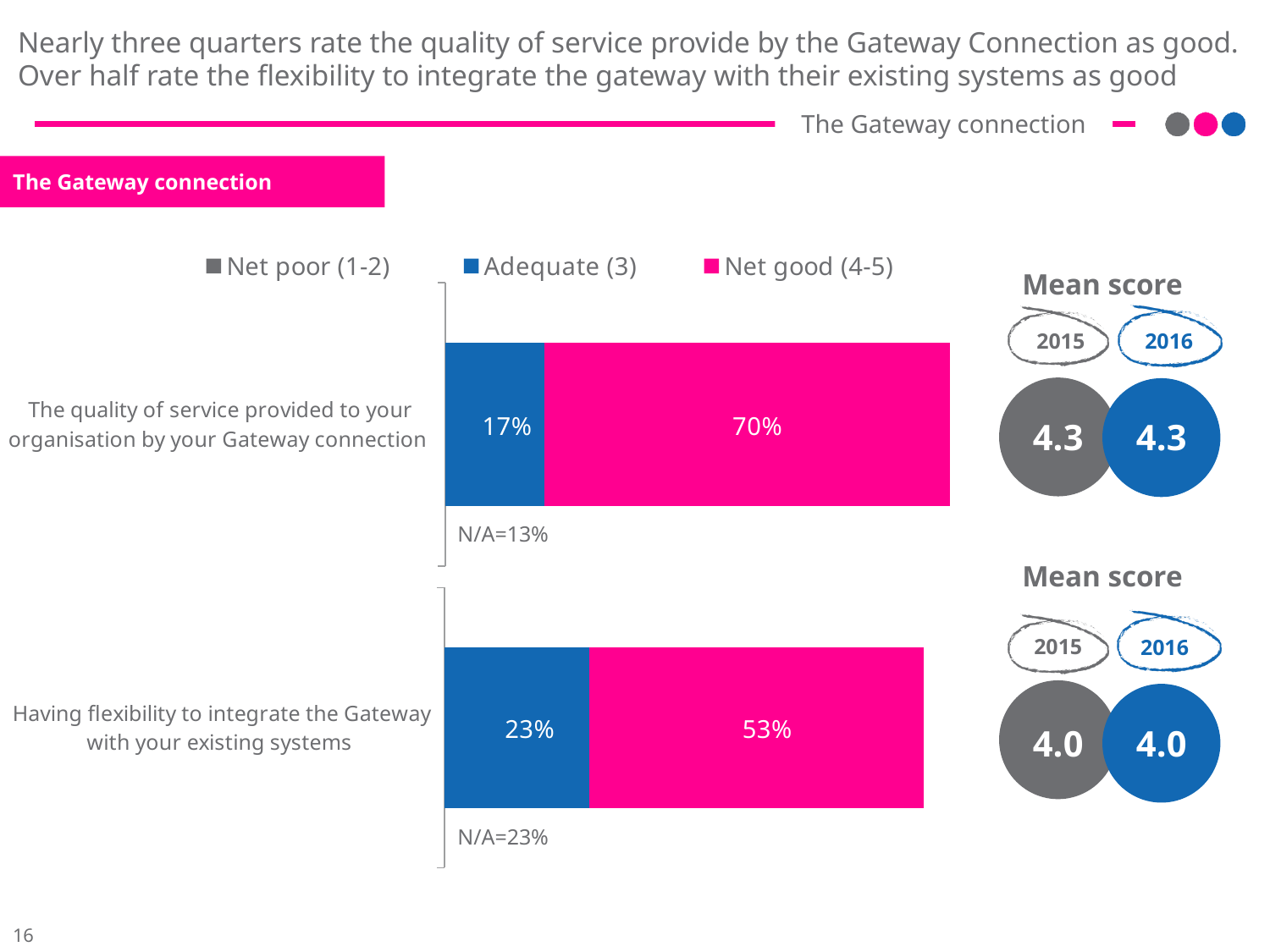
How many series does the chart legend list? 3 What type of chart is shown on the slide? Stacked bar chart What percentage rated having flexibility to integrate the Gateway with existing systems as Net good (4-5)? 53% Which item has the higher Net good (4-5) percentage? The quality of service provided to your organisation by your Gateway connection Is the Adequate (3) percentage larger for the quality of service item or the flexibility to integrate item? Flexibility to integrate What is the N/A percentage shown for having flexibility to integrate the Gateway with your existing systems? N/A=23% What percentage rated the quality of service provided by their Gateway connection as Adequate (3)? 17% What is the N/A percentage shown for the quality of service provided by your Gateway connection? N/A=13% What is the difference in percentage points between the Net good (4-5) values for the two items? 17 percentage points What percentage rated the quality of service provided by their Gateway connection as Net good (4-5)? 70% How many items (categories) are plotted in the chart? 2 What percentage rated having flexibility to integrate the Gateway with existing systems as Adequate (3)? 23%